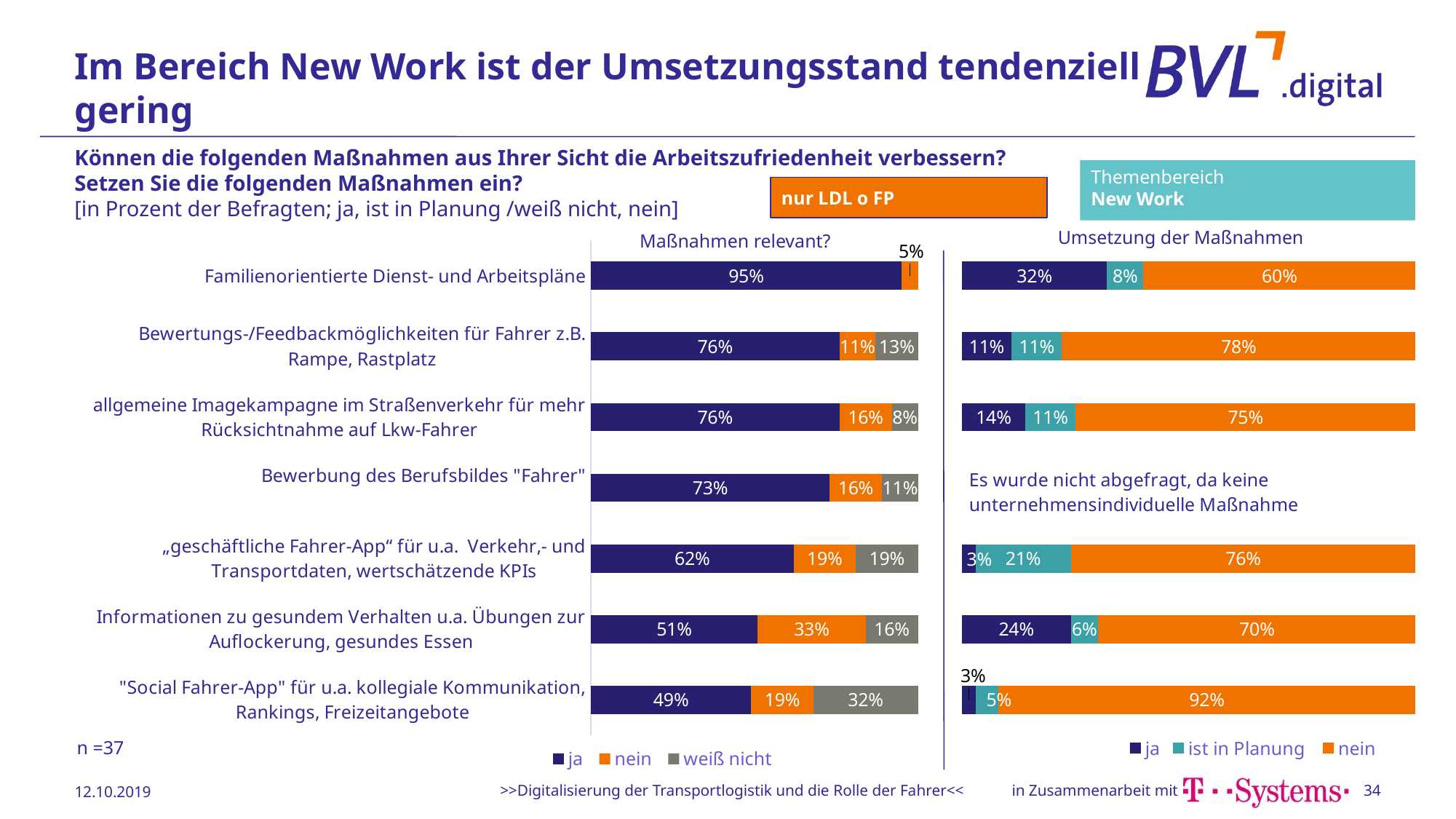
In the "Umsetzung der Maßnahmen" chart, which category has the highest "ja" value? Familienorientierte Dienst- und Arbeitspläne In the "Maßnahmen relevant?" chart, which category has the lowest "ja" value? "Social Fahrer-App" für u.a. kollegiale Kommunikation, Rankings, Freizeitangebote In the "Maßnahmen relevant?" chart, what is the "weiß nicht" value for "Social Fahrer-App"? 32% In the "Umsetzung der Maßnahmen" chart, what is the "nein" value for "Social Fahrer-App"? 92% In the "Umsetzung der Maßnahmen" chart, is the "ja" value for "Informationen zu gesundem Verhalten" larger or smaller than the "ja" value for "allgemeine Imagekampagne"? larger In the "Umsetzung der Maßnahmen" chart, what is the "ist in Planung" value for "geschäftliche Fahrer-App"? 21% In the "Maßnahmen relevant?" chart, what is the "ja" value for "Familienorientierte Dienst- und Arbeitspläne"? 95% How many series does the legend of the "Umsetzung der Maßnahmen" chart list? 3 In the "Maßnahmen relevant?" chart, what is the difference between the "nein" values for "Informationen zu gesundem Verhalten" and "Bewertungs-/Feedbackmöglichkeiten für Fahrer"? 22% What is the sample size (n) stated on the slide? n =37 In the "Maßnahmen relevant?" chart, how many categories are shown? 7 What kind of chart is the "Maßnahmen relevant?" chart? Stacked bar chart